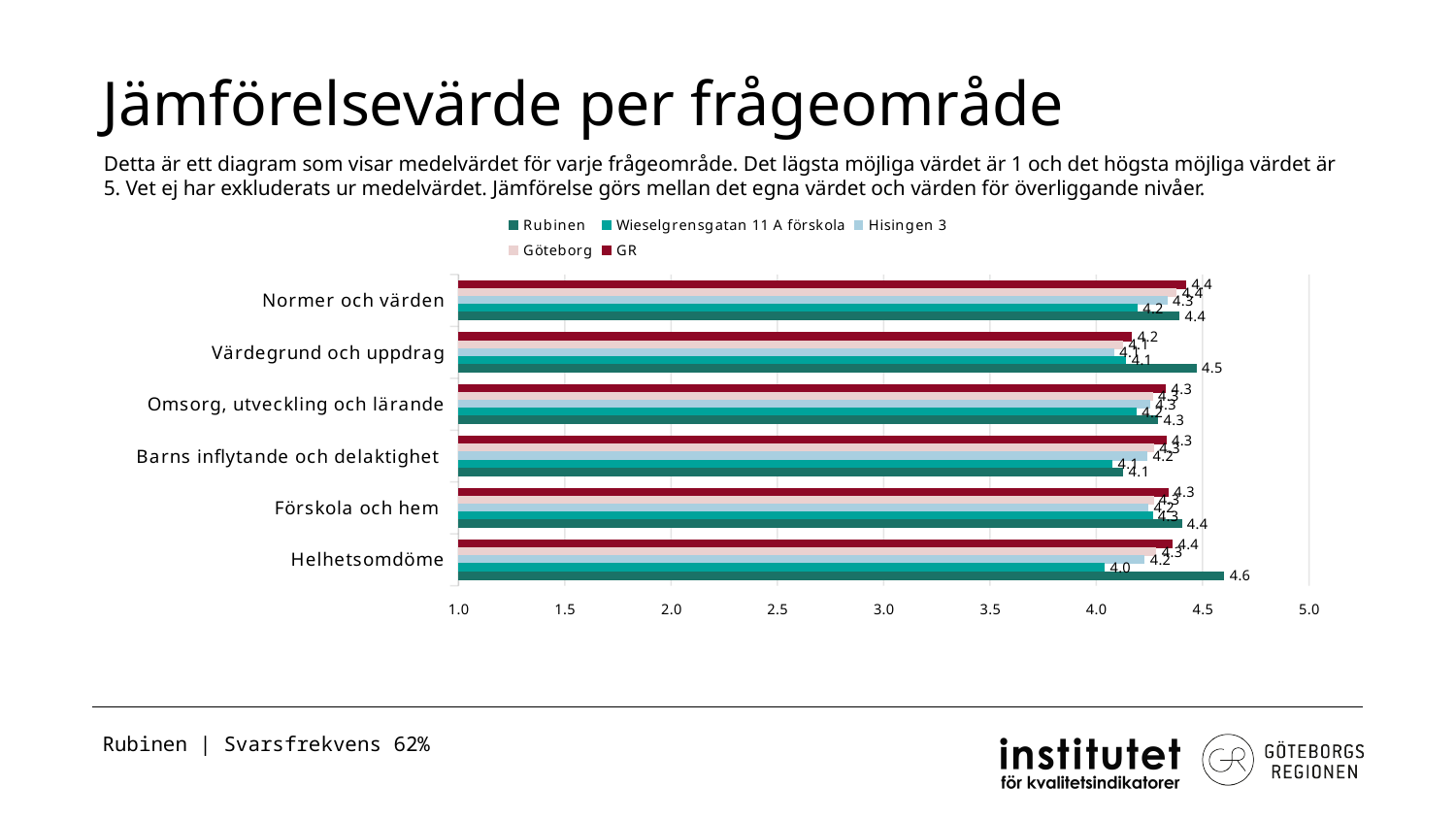
What kind of chart is shown on the slide? Bar chart In which category does Rubinen have its highest value? Helhetsomdöme What is the value for GR in the Normer och värden category? 4.4 How many categories (frågeområden) are shown on the y axis of the chart? 6 What is the value for Wieselgrensgatan 11 A förskola in the Helhetsomdöme category? 4.0 What is the difference between the Rubinen value and the Wieselgrensgatan 11 A förskola value in the Helhetsomdöme category? 0.6 Is the value for Rubinen in the Helhetsomdöme category greater or less than 4.5? greater How many series does the legend list? 5 What is the value for Rubinen in the Helhetsomdöme category? 4.6 In which category does Rubinen have its lowest value? Barns inflytande och delaktighet What is the value for Rubinen in the Värdegrund och uppdrag category? 4.5 In the Värdegrund och uppdrag category, which is larger: the value for Rubinen or the value for Wieselgrensgatan 11 A förskola? Rubinen